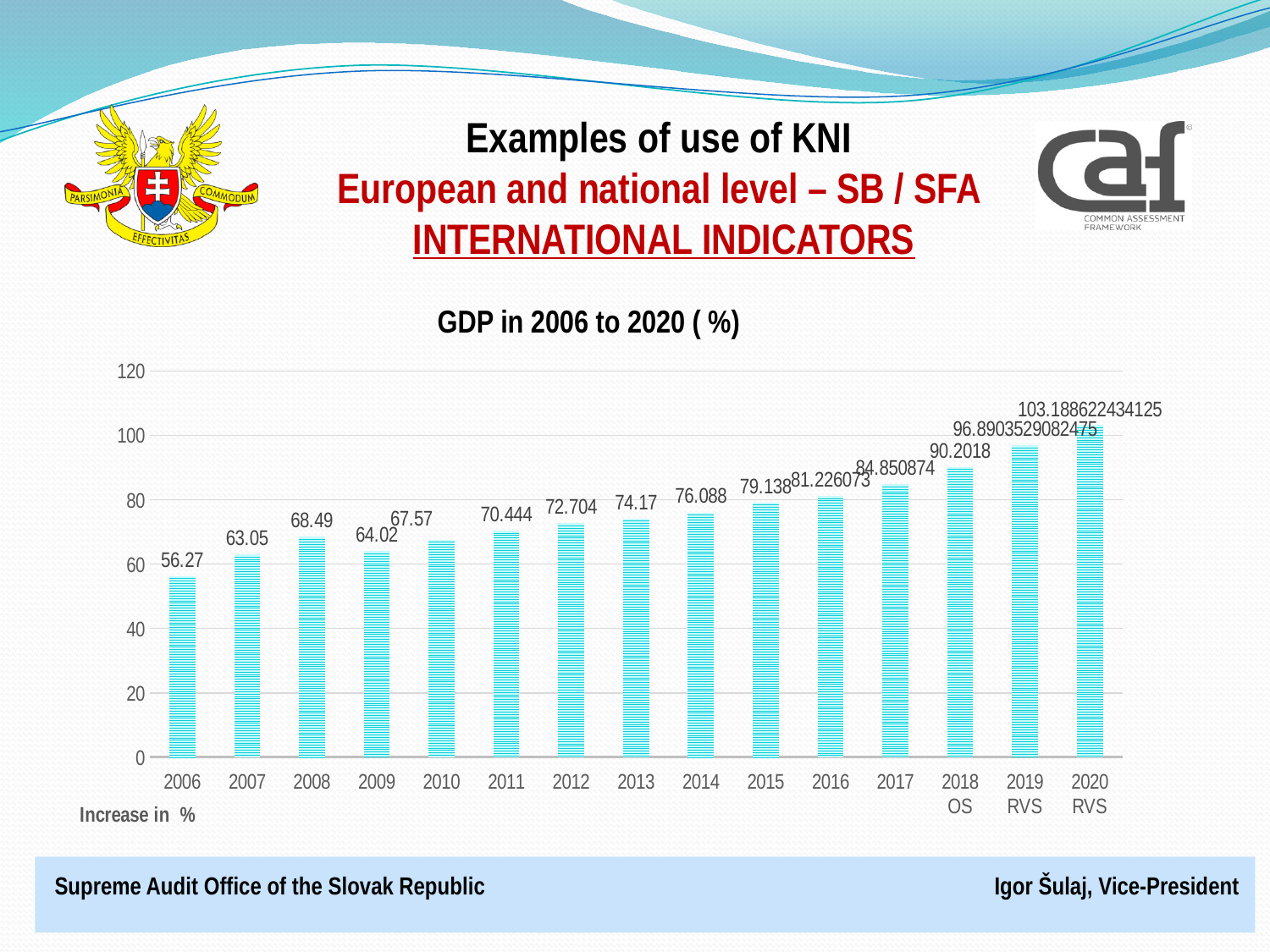
What is the value for 2013? 74.17 Is the value for 2015 greater or less than 80? less What kind of chart is this? bar chart What is the value for 2006? 56.27 Which category has the lowest value? 2006 What is the value for 2018 OS? 90.2018 What is the value for 2020 RVS? 103.188622434125 Which is larger, the value for 2008 or the value for 2009? 2008 Which category has the highest value? 2020 RVS How many categories are shown on the x axis? 15 What is the title of the chart? GDP in 2006 to 2020 ( %) What is the difference between the values for 2007 and 2006? 6.78